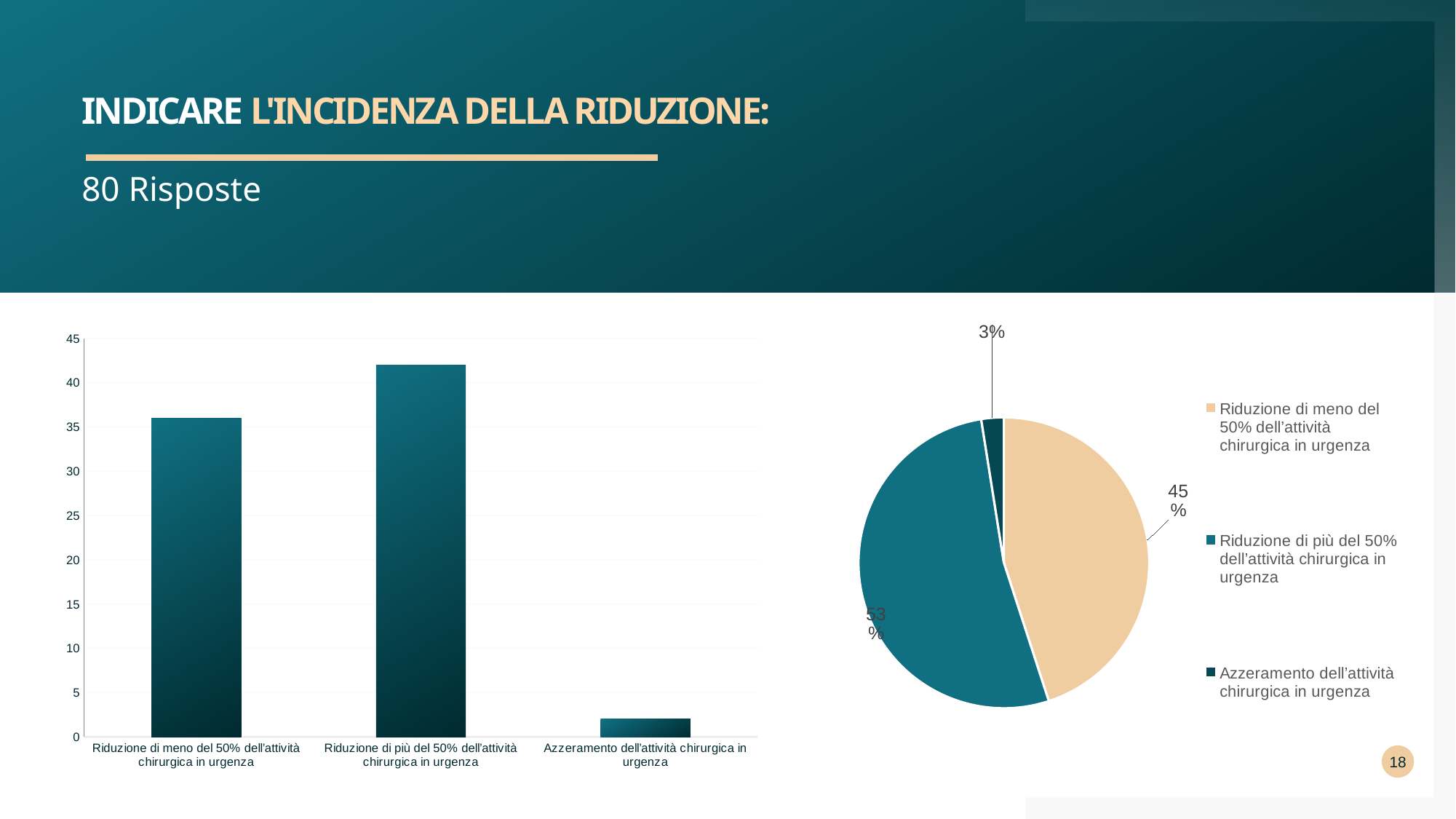
What kind of chart is on the right side of the slide? pie chart In the bar chart on the left, which category has the highest bar? Riduzione di più del 50% dell'attività chirurgica in urgenza In the bar chart on the left, is the value for 'Riduzione di più del 50% dell'attività chirurgica in urgenza' greater or less than 40? greater In the bar chart on the left, how many categories are shown? 3 In the bar chart on the left, is the value for 'Azzeramento dell'attività chirurgica in urgenza' greater or less than 5? less In the pie chart on the right, how many entries does the legend list? 3 What kind of chart is on the left side of the slide? bar chart In the pie chart on the right, what is the difference between the shares of 'Riduzione di più del 50%' and 'Riduzione di meno del 50%'? 8% In the bar chart on the left, which category has the lowest bar? Azzeramento dell'attività chirurgica in urgenza In the pie chart on the right, what share does 'Riduzione di più del 50% dell'attività chirurgica in urgenza' have? 53% In the bar chart on the left, is the value for 'Riduzione di meno del 50% dell'attività chirurgica in urgenza' greater or less than 35? greater In the pie chart on the right, what share does 'Azzeramento dell'attività chirurgica in urgenza' have? 3%